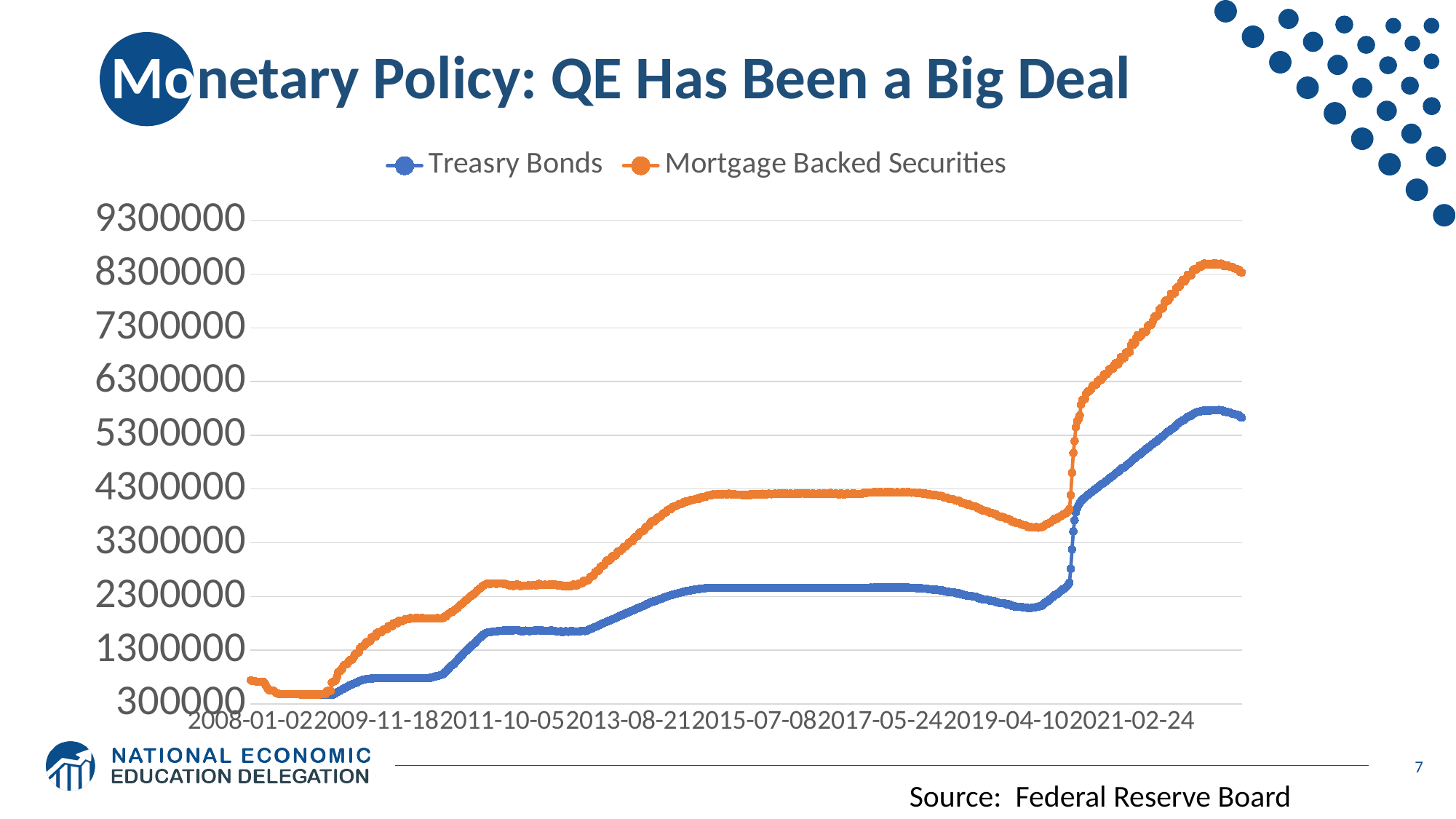
How many series does the legend list? 2 Is the peak value of the Mortgage Backed Securities series greater or less than 7300000? greater Is the Mortgage Backed Securities value around 2017-05-24 greater or less than 3300000? greater Which colour is used for the Mortgage Backed Securities series? orange Which series reaches the higher value at the right end of the chart, Treasry Bonds or Mortgage Backed Securities? Mortgage Backed Securities Overall, do the Treasry Bonds values rise or fall from 2008-01-02 to the end of the chart? rise Is the value of Treasry Bonds at 2008-01-02 greater or less than 1300000? less What is the highest value shown on the vertical axis? 9300000 What kind of chart is shown on the slide? line chart Overall, do the Mortgage Backed Securities values rise or fall across the chart? rise What are the two series named in the legend? Treasry Bonds and Mortgage Backed Securities